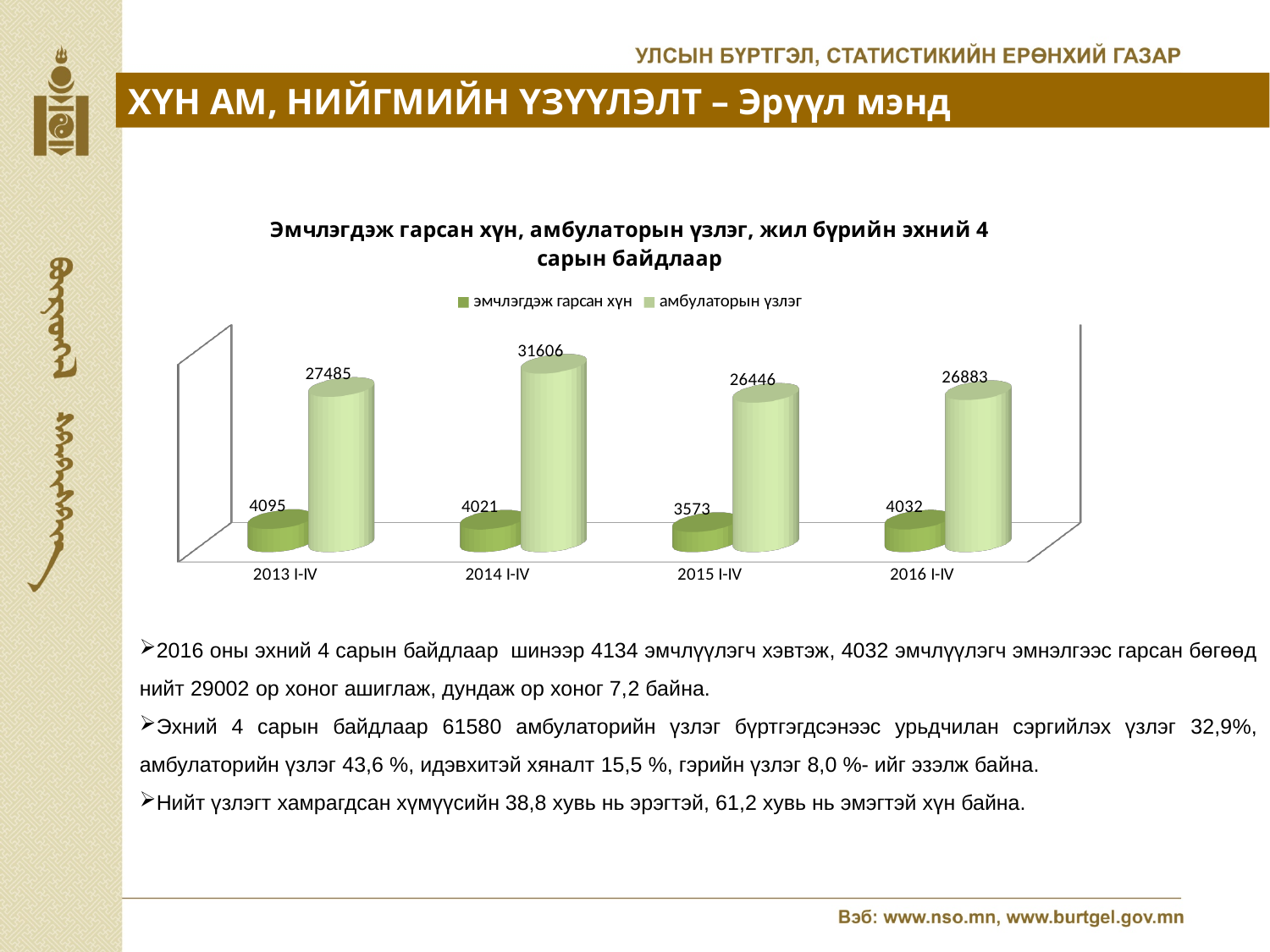
What is the value for амбулаторын үзлэг in 2014 I-IV? 31606 What is the value for эмчлэгдэж гарсан хүн in 2015 I-IV? 3573 Which is larger: эмчлэгдэж гарсан хүн in 2013 I-IV or in 2016 I-IV? 2013 I-IV What is the difference between эмчлэгдэж гарсан хүн in 2013 I-IV and 2014 I-IV? 74 In which period is амбулаторын үзлэг highest? 2014 I-IV How many periods are shown on the x axis? 4 What kind of chart is shown on the slide? Bar chart How many series does the legend list? 2 In which period is эмчлэгдэж гарсан хүн lowest? 2015 I-IV What is the value for амбулаторын үзлэг in 2016 I-IV? 26883 What is the value for эмчлэгдэж гарсан хүн in 2013 I-IV? 4095 What is the difference between амбулаторын үзлэг in 2014 I-IV and 2015 I-IV? 5160